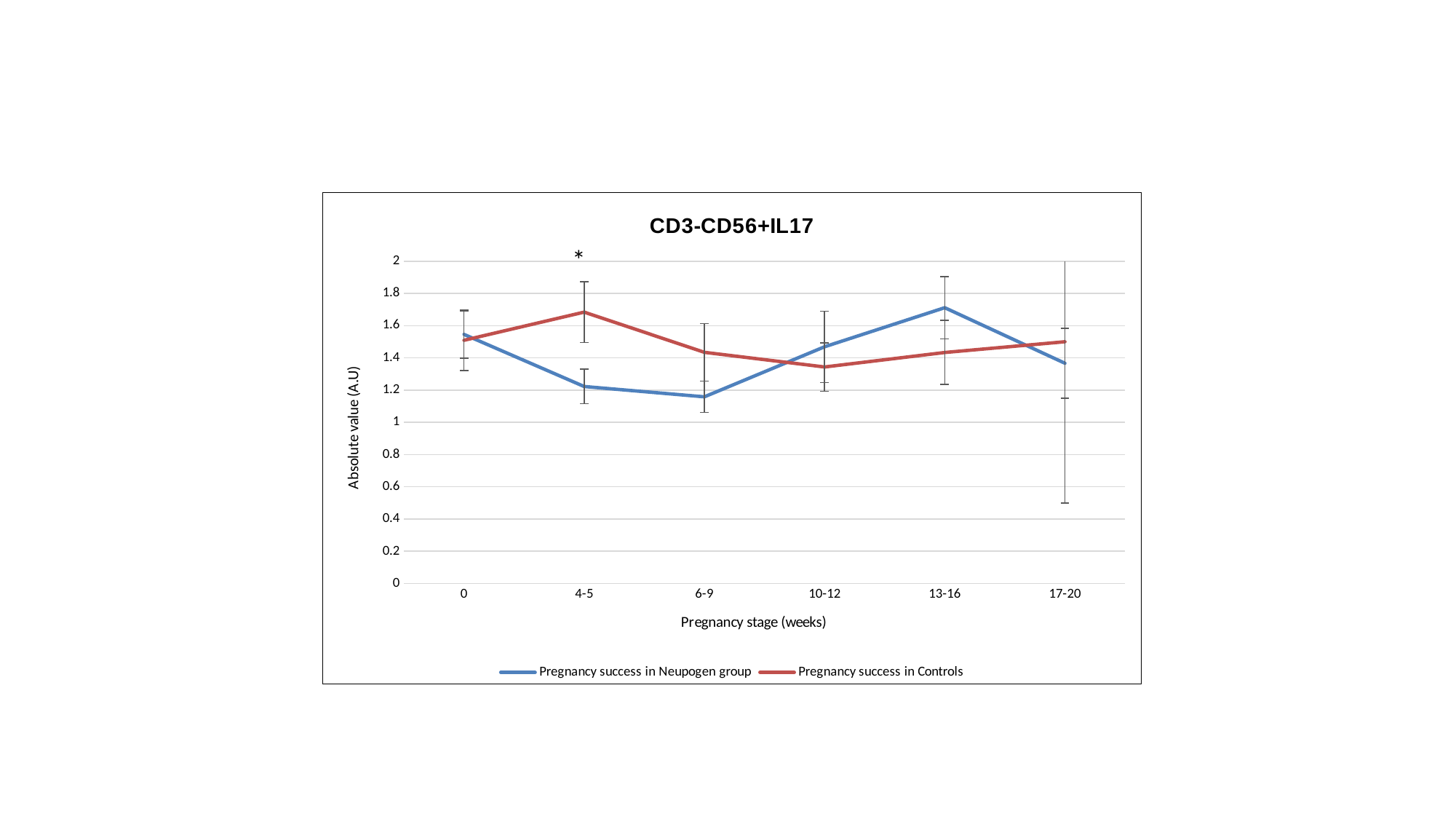
What kind of chart is shown on the slide? line chart How many series does the legend list? 2 At pregnancy stage 4-5, which series has the larger value, the Neupogen group or Controls? Controls At pregnancy stage 13-16, which series has the larger value, the Neupogen group or Controls? Neupogen group At which pregnancy stage is the value for the Neupogen group highest? 13-16 How many pregnancy stage categories are shown on the x axis? 6 At which pregnancy stage is the value for Controls lowest? 10-12 What is the title of the chart? CD3-CD56+IL17 Does the Neupogen group line rise or fall from stage 6-9 to stage 13-16? rise Is the value for Controls at stage 4-5 greater or less than 1.6? greater At which pregnancy stage is the value for Controls highest? 4-5 Is the value for the Neupogen group at stage 6-9 greater or less than 1.4? less